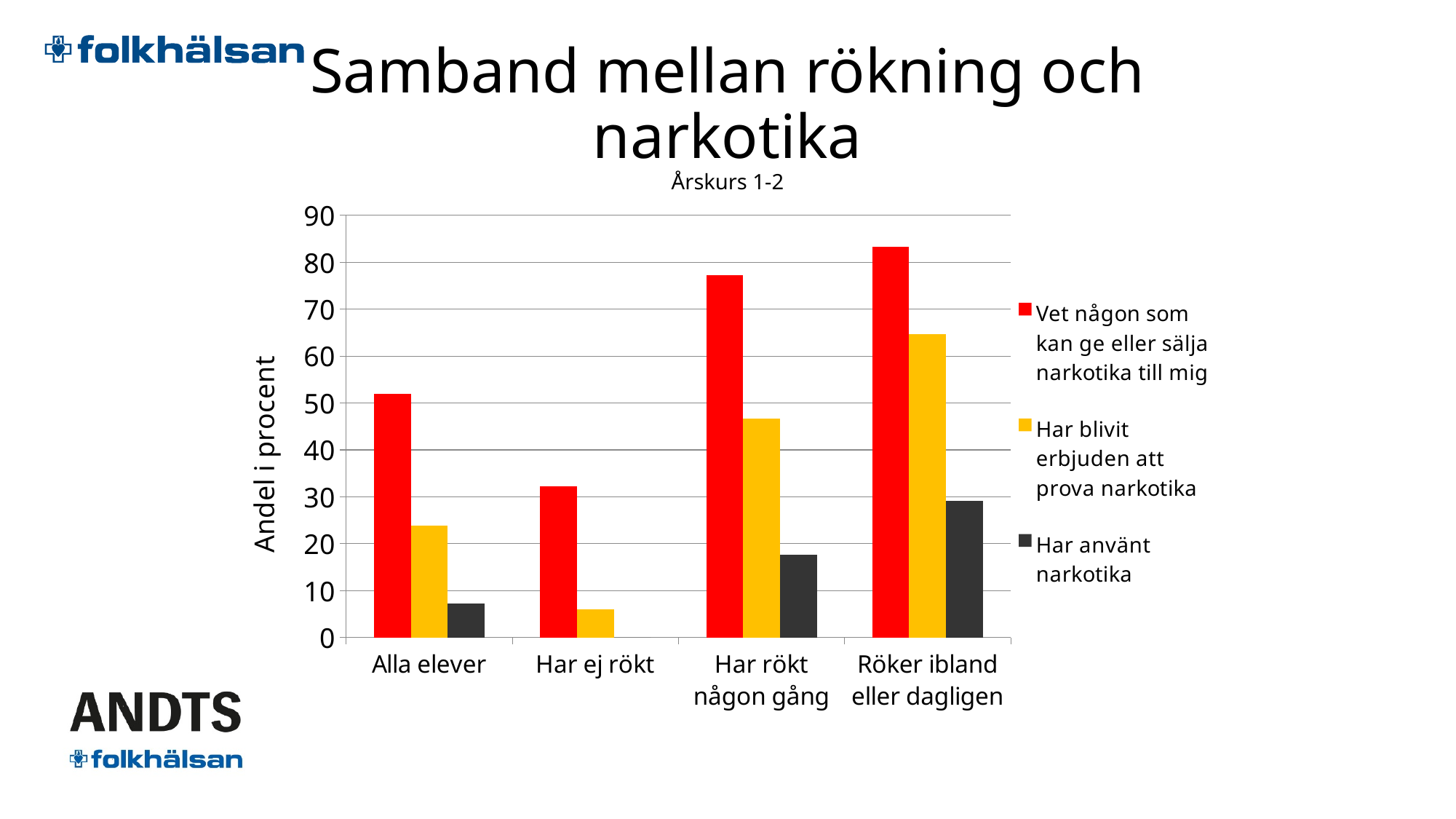
Which is larger for 'Vet någon som kan ge eller sälja narkotika till mig': 'Har rökt någon gång' or 'Röker ibland eller dagligen'? Röker ibland eller dagligen What subtitle appears below the chart title? Årskurs 1-2 Is the value for 'Har blivit erbjuden att prova narkotika' in the 'Har ej rökt' category greater or less than 10? less Which category has the highest value for 'Vet någon som kan ge eller sälja narkotika till mig'? Röker ibland eller dagligen How many series does the legend list? 3 Is the value for 'Har blivit erbjuden att prova narkotika' in the 'Har rökt någon gång' category greater or less than 40? greater What kind of chart is shown on the slide? bar chart Which category has the lowest value for 'Har blivit erbjuden att prova narkotika'? Har ej rökt Is the value for 'Vet någon som kan ge eller sälja narkotika till mig' in the 'Alla elever' category greater or less than 40? greater What is the title of the y axis? Andel i procent How many categories are shown on the x axis? 4